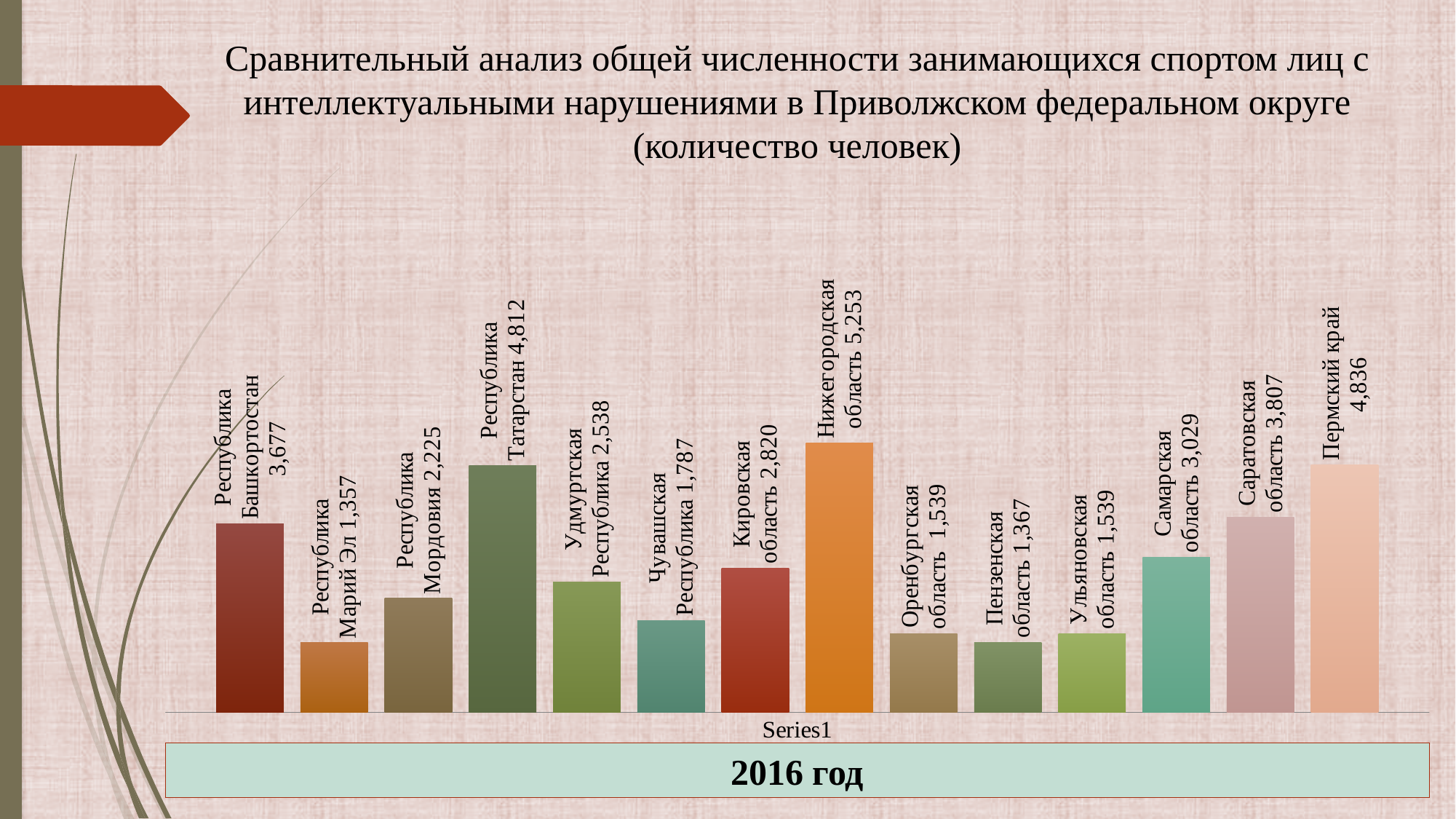
Which region has the highest value in the chart? Нижегородская область Which year does the chart refer to, according to the label below the chart? 2016 год What is the value for Чувашская Республика? 1,787 What is the value for Республика Татарстан? 4,812 Which is larger, the value for Кировская область or the value for Удмуртская Республика? Кировская область How many regions (bars) are shown in the chart? 14 What is the difference between the values for Саратовская область and Самарская область? 778 What kind of chart is shown on the slide? bar chart Which region has the lowest value in the chart? Республика Марий Эл What is the value for Нижегородская область? 5,253 What is the difference between the values for Пермский край and Республика Татарстан? 24 What is the value for Самарская область? 3,029